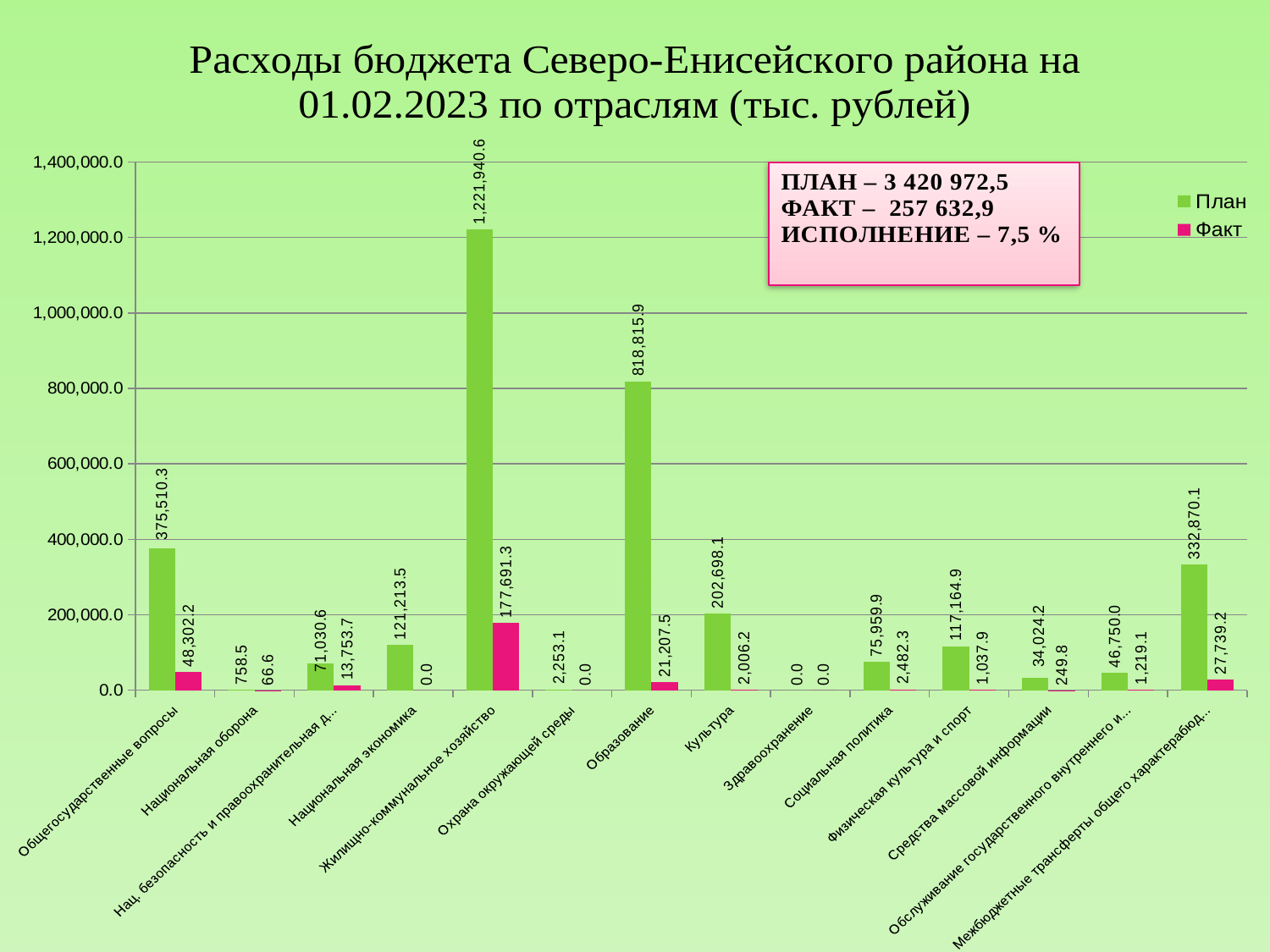
What is the difference between the План and Факт values for Общегосударственные вопросы? 327,208.1 Which category has the lowest План value? Здравоохранение How many categories are shown on the x axis? 14 What is the План value for Образование? 818,815.9 What is the Факт value for Культура? 2,006.2 What is the Факт value for Жилищно-коммунальное хозяйство? 177,691.3 What is the План value for Межбюджетные трансферты общего характера? 332,870.1 Which has the larger План value, Культура or Физическая культура и спорт? Культура How many series does the legend list? 2 Which category has the highest План value? Жилищно-коммунальное хозяйство What kind of chart is shown on the slide? Bar chart What is the difference between the План and Факт values for Образование? 797,608.4